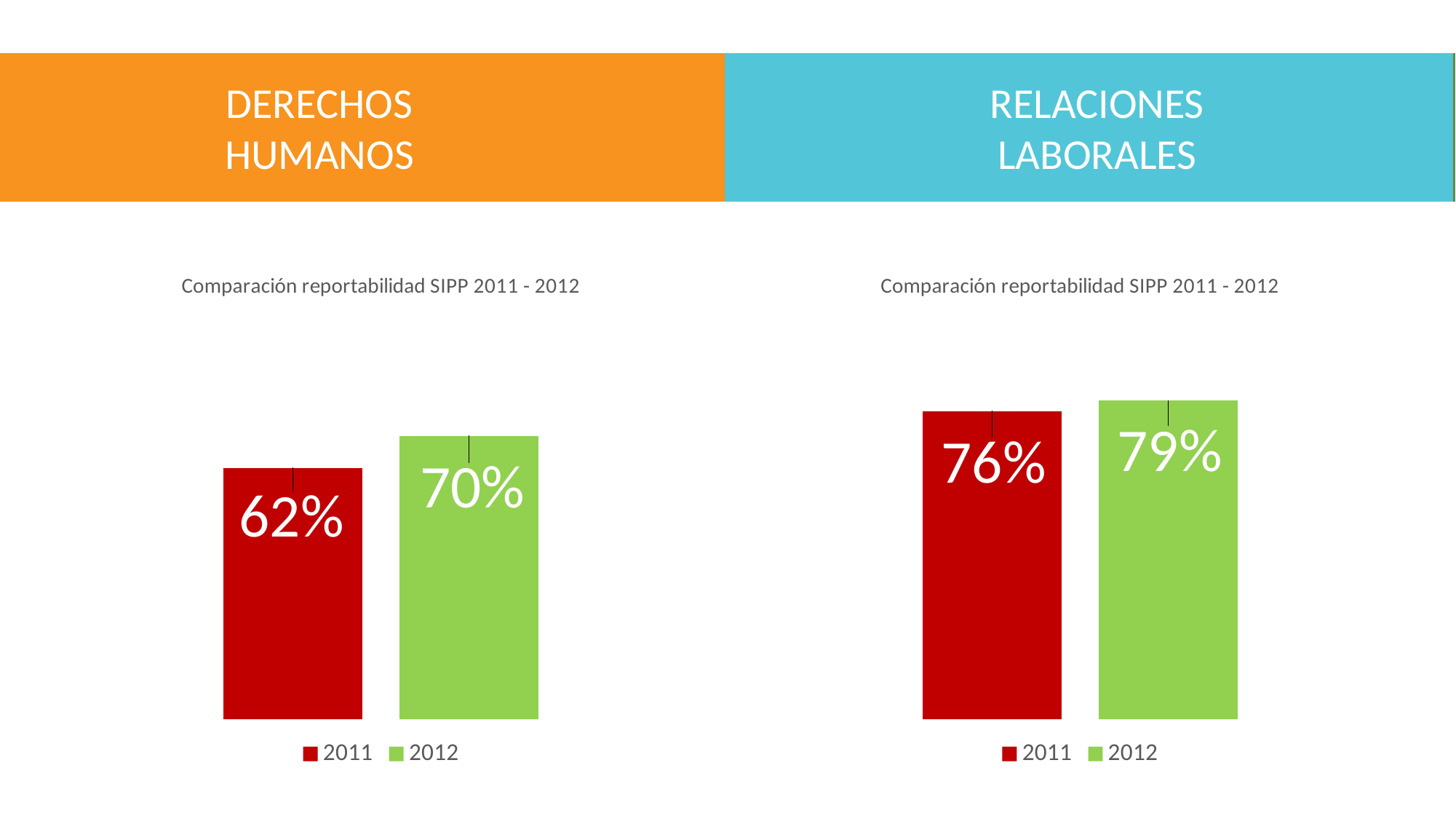
In the Derechos Humanos chart, which year has the higher value? 2012 Is the 2011 value in the Derechos Humanos chart larger or smaller than the 2011 value in the Relaciones Laborales chart? smaller In the Relaciones Laborales chart, what is the difference between the 2012 and 2011 values? 3% In the Derechos Humanos chart, what is the value for 2012? 70% What is the title of the chart under Relaciones Laborales? Comparación reportabilidad SIPP 2011 - 2012 In the Derechos Humanos chart, what is the difference between the 2012 and 2011 values? 8% How many series does the legend of the Relaciones Laborales chart list? 2 In the Relaciones Laborales chart, which year has the lower value? 2011 In the Relaciones Laborales chart, what is the value for 2012? 79% In the Derechos Humanos chart, what is the value for 2011? 62% What kind of chart is used under Derechos Humanos? bar chart In the Relaciones Laborales chart, what is the value for 2011? 76%